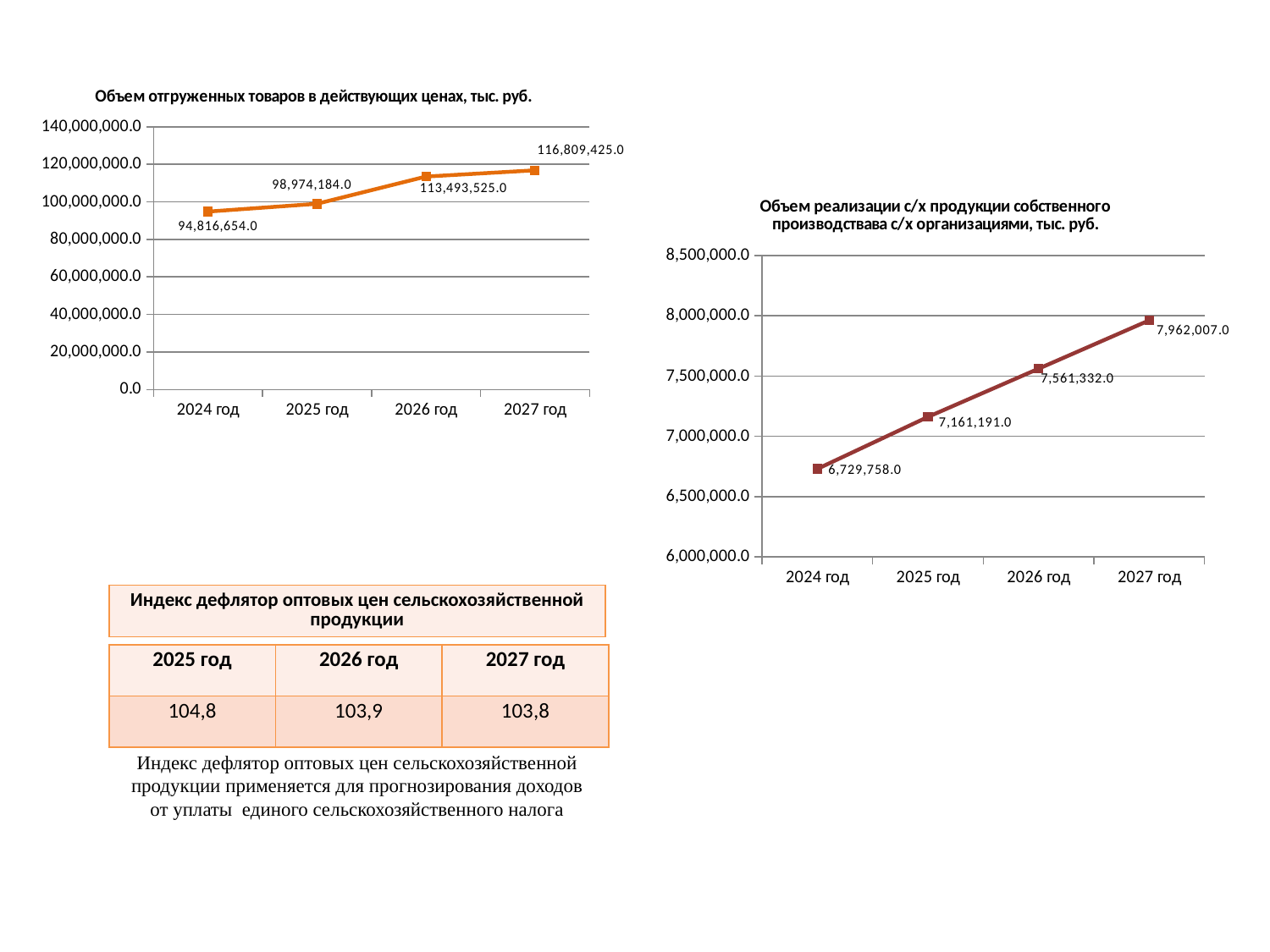
In the chart 'Объем реализации с/х продукции собственного производствава с/х организациями, тыс. руб.', what is the value for 2026 год? 7,561,332.0 In the chart 'Объем реализации с/х продукции собственного производствава с/х организациями, тыс. руб.', which year has the highest value? 2027 год In the chart 'Объем отгруженных товаров в действующих ценах, тыс. руб.', which year has the lowest value? 2024 год In the chart 'Объем отгруженных товаров в действующих ценах, тыс. руб.', do the values rise or fall from 2024 год to 2027 год? rise In the chart 'Объем отгруженных товаров в действующих ценах, тыс. руб.', what is the difference between the 2027 год and 2024 год values? 21,992,771.0 In the chart 'Объем отгруженных товаров в действующих ценах, тыс. руб.', what is the value for 2027 год? 116,809,425.0 In the chart 'Объем отгруженных товаров в действующих ценах, тыс. руб.', is the value for 2026 год greater or less than 100,000,000.0? greater In the chart 'Объем реализации с/х продукции собственного производствава с/х организациями, тыс. руб.', how many years are plotted? 4 What type of chart is the chart on the right side of the slide? line chart In the chart 'Объем реализации с/х продукции собственного производствава с/х организациями, тыс. руб.', what is the difference between the 2027 год and 2024 год values? 1,232,249.0 In the chart 'Объем отгруженных товаров в действующих ценах, тыс. руб.', what is the value for 2025 год? 98,974,184.0 In the chart 'Объем реализации с/х продукции собственного производствава с/х организациями, тыс. руб.', what is the value for 2024 год? 6,729,758.0